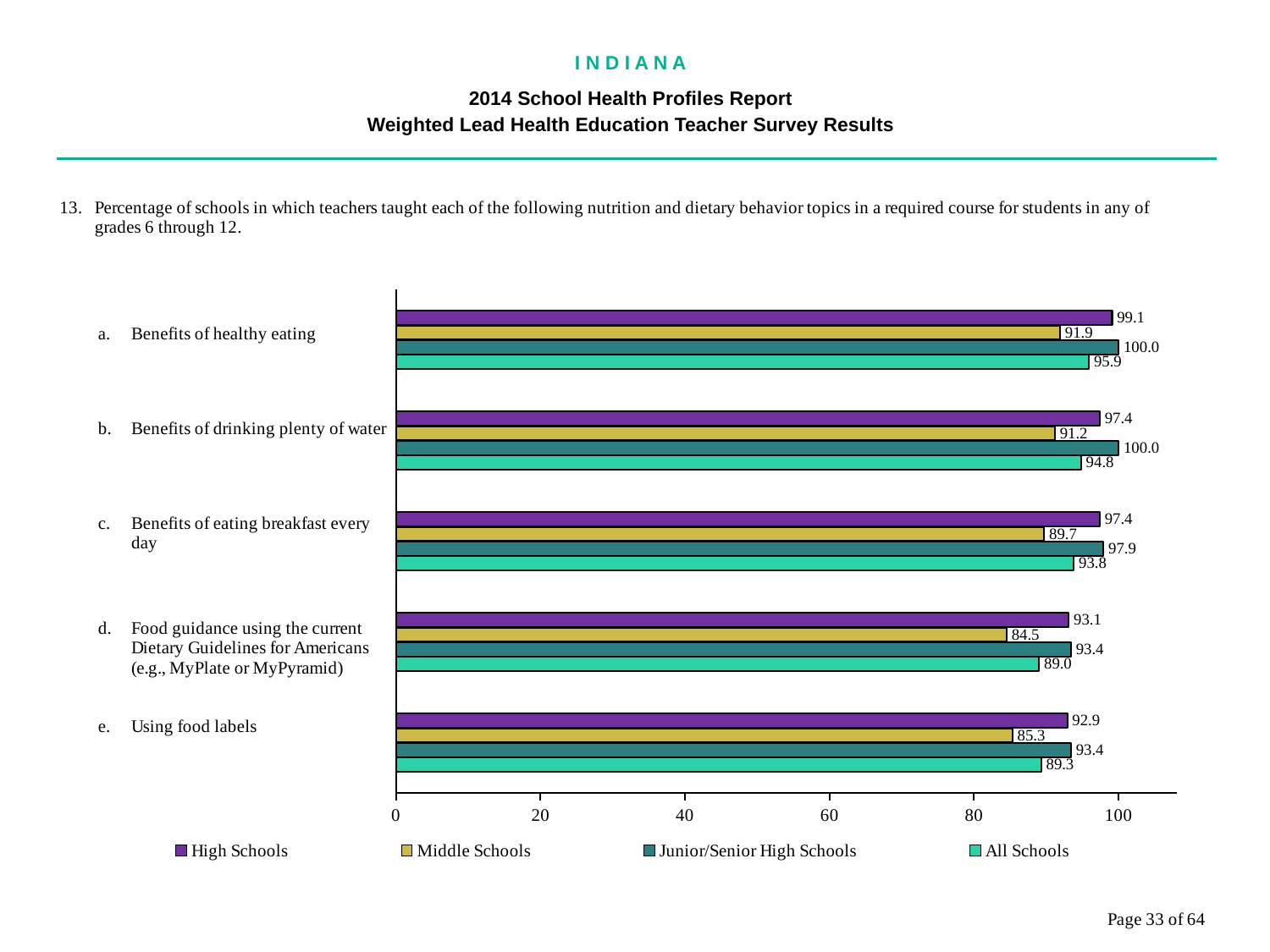
How many series does the legend list? 4 Which topic has the lowest Middle Schools value? Food guidance using the current Dietary Guidelines for Americans (e.g., MyPlate or MyPyramid) Which series is shown in purple in the legend? High Schools How many nutrition and dietary behavior topics are shown on the chart? 5 What is the Middle Schools value for Food guidance using the current Dietary Guidelines for Americans? 84.5 What is the difference between the High Schools and Middle Schools values for Benefits of eating breakfast every day? 7.7 Which is larger for Benefits of drinking plenty of water: the High Schools value or the Middle Schools value? High Schools Is the Middle Schools value for Using food labels greater or less than 80? greater What is the All Schools value for Using food labels? 89.3 What kind of chart is shown on the slide? bar chart What is the High Schools value for Benefits of healthy eating? 99.1 Which topic has the highest All Schools value? Benefits of healthy eating